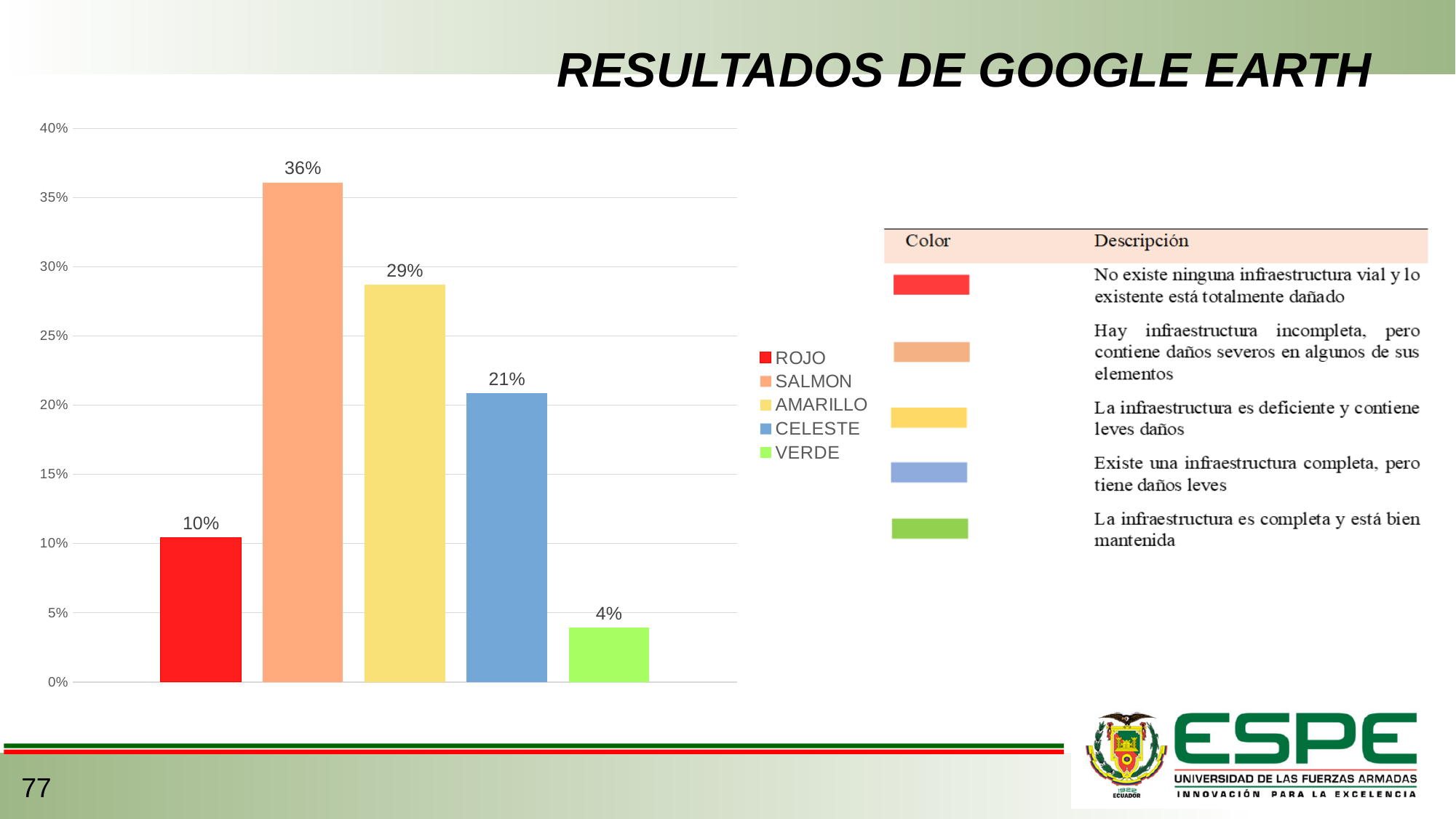
What kind of chart is shown on the slide? bar chart Which category has the highest value? SALMON How many bars are plotted in the chart? 5 What is the value for CELESTE? 21% What is the value for SALMON? 36% Which is larger, the value for AMARILLO or the value for CELESTE? AMARILLO What is the value for VERDE? 4% What is the difference between the values for ROJO and VERDE? 6% How many entries does the chart legend list? 5 Is the value for ROJO greater or less than 15%? less Which category has the lowest value? VERDE What is the difference between the values for SALMON and AMARILLO? 7%